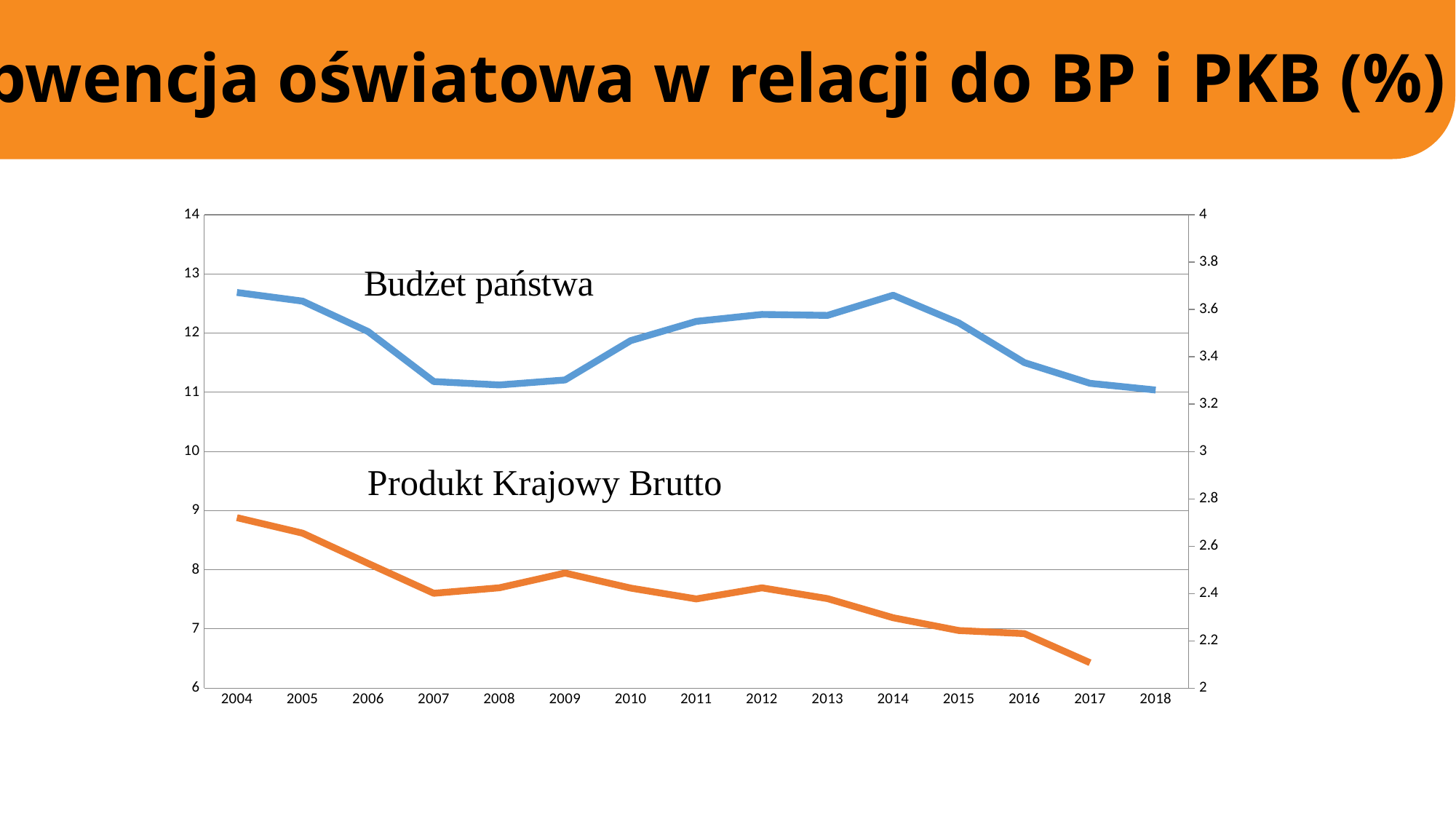
Is the Budżet państwa value for 2007 greater or less than 12? less In which year is the Produkt Krajowy Brutto line at its highest? 2004 Is the Produkt Krajowy Brutto value for 2017 greater or less than 2.2 on the right axis? less Which series is drawn in orange? Produkt Krajowy Brutto How many data series (lines) are plotted on the chart? 2 How many years are shown on the x axis of the chart? 15 In which year is the Produkt Krajowy Brutto line at its lowest? 2017 Does the Produkt Krajowy Brutto line generally rise or fall from 2004 to 2017? fall Which year has the larger Budżet państwa value, 2004 or 2008? 2004 Is the Produkt Krajowy Brutto value for 2004 greater or less than 2.6 on the right axis? greater What kind of chart is shown on the slide? line chart